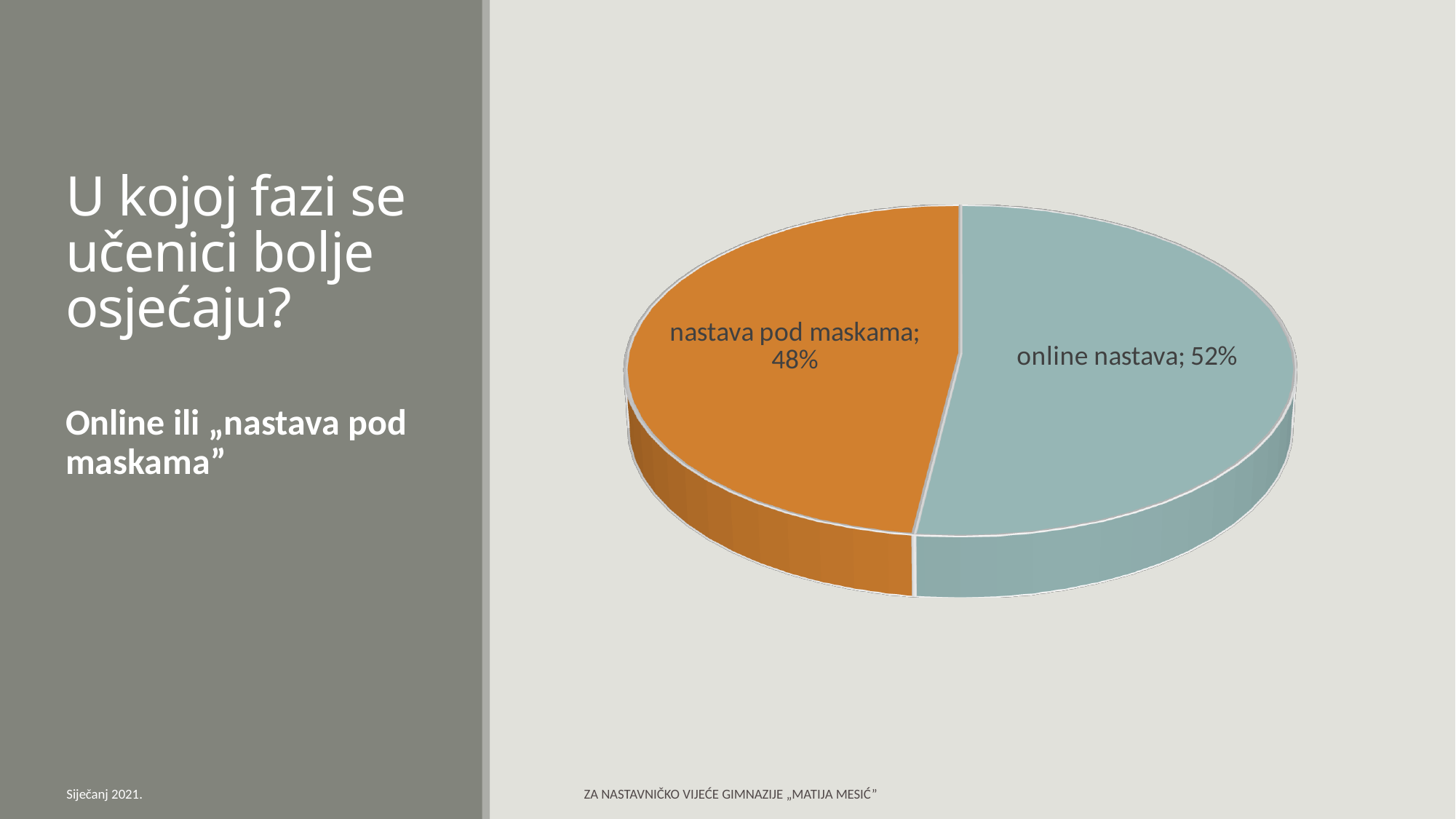
What colour is the "online nastava" slice of the pie chart? blue-grey What is the difference in percentage points between the "online nastava" slice and the "nastava pod maskama" slice? 4 What share of the pie does the "nastava pod maskama" slice represent? 48% What colour is the "nastava pod maskama" slice of the pie chart? orange What percentage of the pie chart is labelled "online nastava"? 52% Which slice of the pie chart is the smallest? nastava pod maskama What percentage of the pie chart is labelled "nastava pod maskama"? 48% Which slice of the pie chart is the largest? online nastava What kind of chart is shown on the slide? pie chart Which is larger: the "online nastava" slice or the "nastava pod maskama" slice? online nastava How many slices does the pie chart have? 2